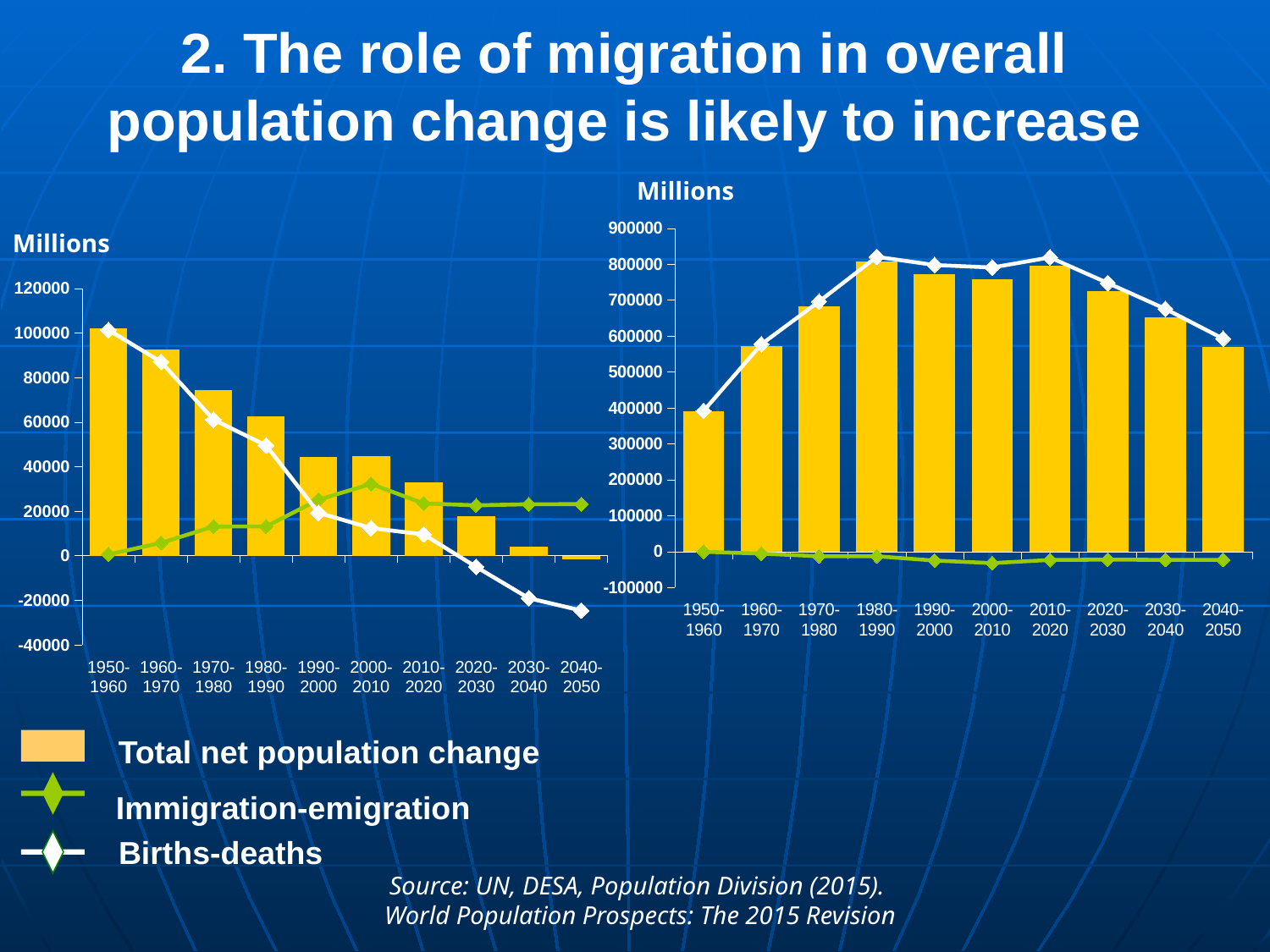
How many series does the legend list for the charts on the slide? 3 What kind of chart is the right chart? Bar chart with line series In the left chart, do the Total net population change bars rise or fall from 1950-1960 to 2040-2050? fall In the left chart, which period has the lowest Total net population change bar? 2040-2050 In the left chart, how many time periods are shown on the x axis? 10 In the left chart, which period has the highest Total net population change bar? 1950-1960 In the left chart, is the Total net population change for 1950-1960 greater or less than 80000? greater In the right chart, is the Total net population change for 1950-1960 greater or less than 500000? less In the right chart, is the Total net population change for 1980-1990 greater or less than 700000? greater In the right chart, which is larger, the Total net population change bar for 1950-1960 or for 1980-1990? 1980-1990 In the right chart, which period has the lowest Total net population change bar? 1950-1960